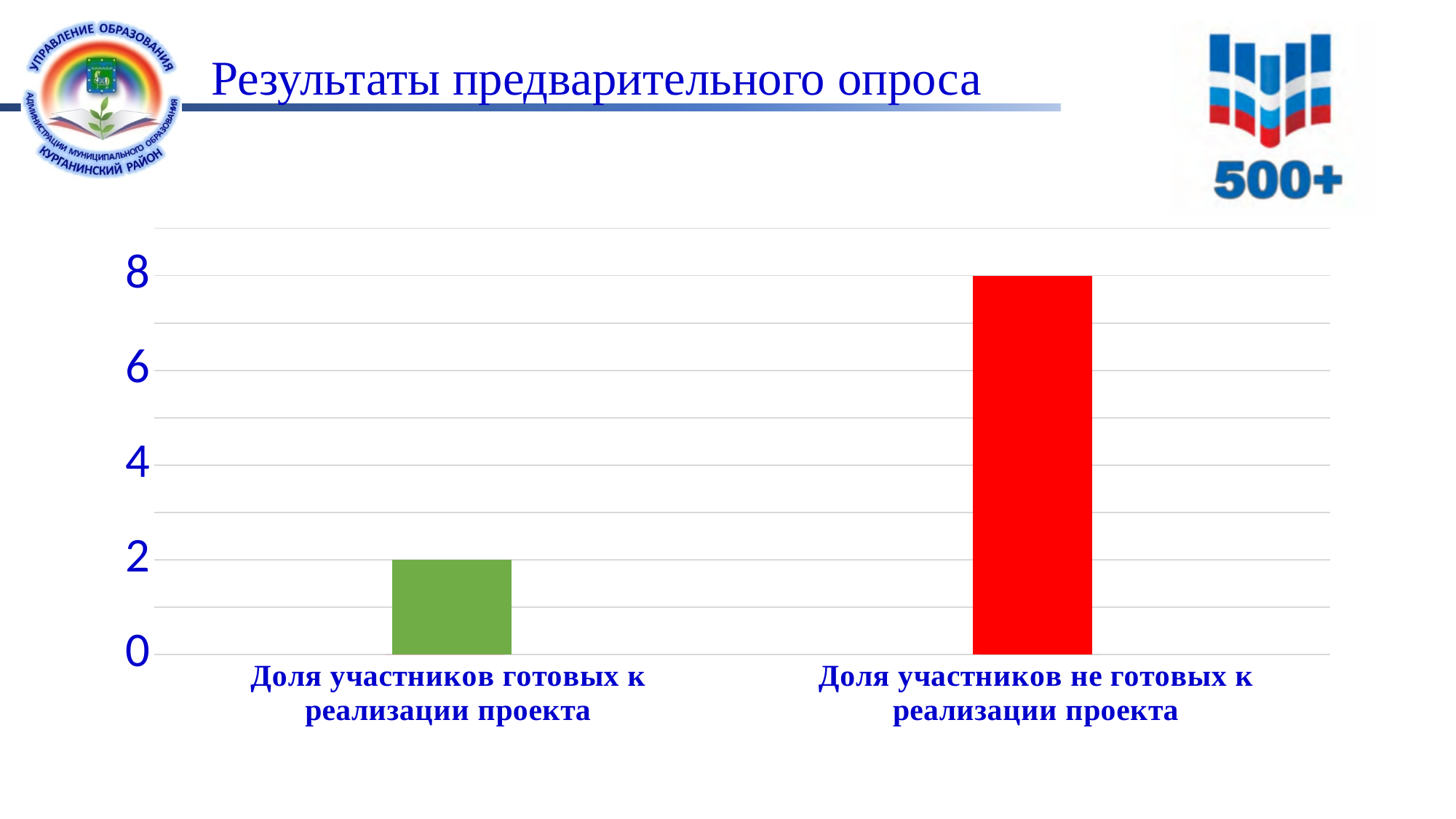
Is the value for "Доля участников готовых к реализации проекта" greater or less than 4? less Is the value for "Доля участников не готовых к реализации проекта" greater or less than 4? greater Which category has the highest value? Доля участников не готовых к реализации проекта What type of chart is shown on the slide? bar chart What is the value for "Доля участников не готовых к реализации проекта"? 8 Which category has the lowest value? Доля участников готовых к реализации проекта What is the value for "Доля участников готовых к реализации проекта"? 2 What is the difference between the value for "Доля участников не готовых к реализации проекта" and the value for "Доля участников готовых к реализации проекта"? 6 How many categories are plotted in the chart? 2 Which is larger: the value for "Доля участников готовых к реализации проекта" or the value for "Доля участников не готовых к реализации проекта"? Доля участников не готовых к реализации проекта What colour is the bar for "Доля участников не готовых к реализации проекта"? red What is the title shown above the chart on the slide? Результаты предварительного опроса